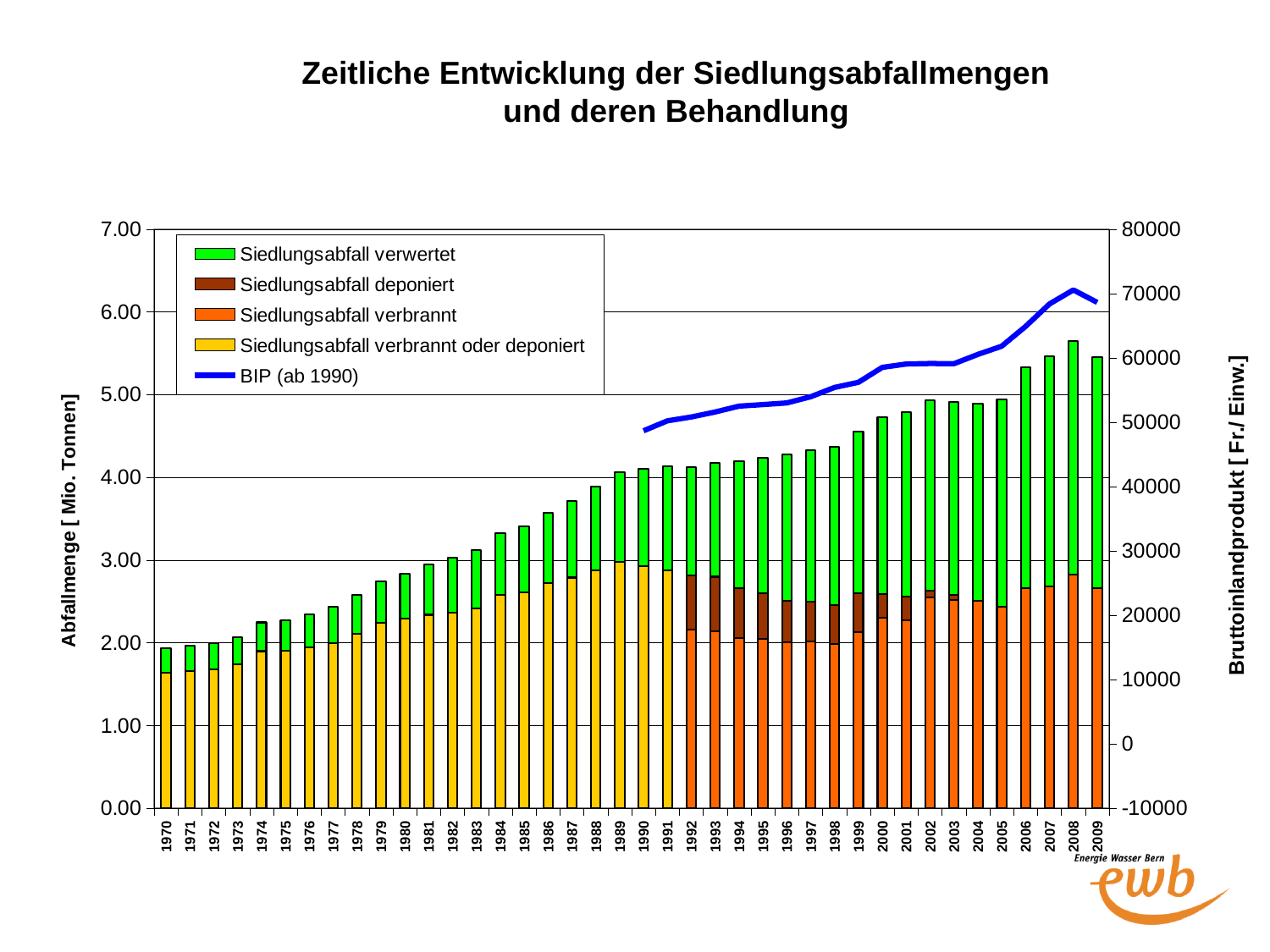
What colour is the BIP (ab 1990) line in the legend? Blue Is the total stacked bar for 1980 greater or less than 3.00 Mio. Tonnen? less Does the BIP line generally rise or fall from 1990 to 2008? rise Is the BIP value for 1990 greater or less than 50000 Fr./Einw.? less Which year has the tallest stacked bar? 2008 How many years are shown along the x axis? 40 Is the BIP value for 2000 greater or less than 55000 Fr./Einw.? greater What kind of chart is shown on the slide? Stacked bar chart with a line Which year has the larger total stacked bar, 1970 or 2008? 2008 How many series does the legend list? 5 What is the label of the right-hand y axis? Bruttoinlandprodukt [ Fr./ Einw.]